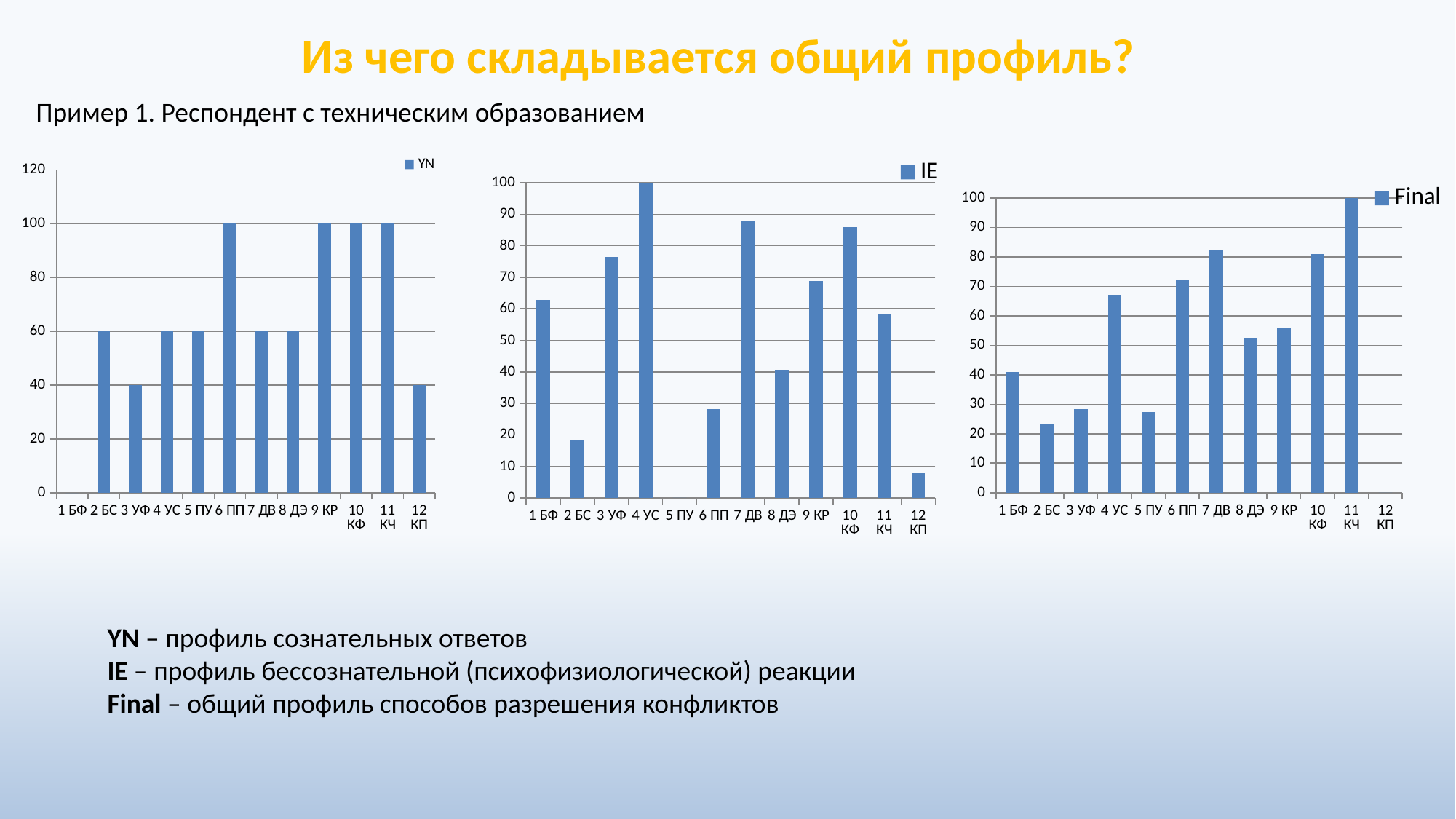
In the IE chart, which category has the lowest non-zero value? 12 КП In the YN chart, what is the value for 6 ПП? 100 How many series does the legend of the IE chart list? 1 How many categories are shown on the x axis of the Final chart? 12 In the YN chart, what is the value for 3 УФ? 40 In the IE chart, is the value for 7 ДВ greater or less than 80? greater What kind of chart is the YN chart on the left? bar chart In the Final chart, which is larger, the value for 7 ДВ or the value for 8 ДЭ? 7 ДВ In the IE chart, which category has the highest value? 4 УС In the YN chart, what is the value for 2 БС? 60 In the Final chart, which category has the highest value? 11 КЧ In the Final chart, is the value for 2 БС greater or less than 30? less